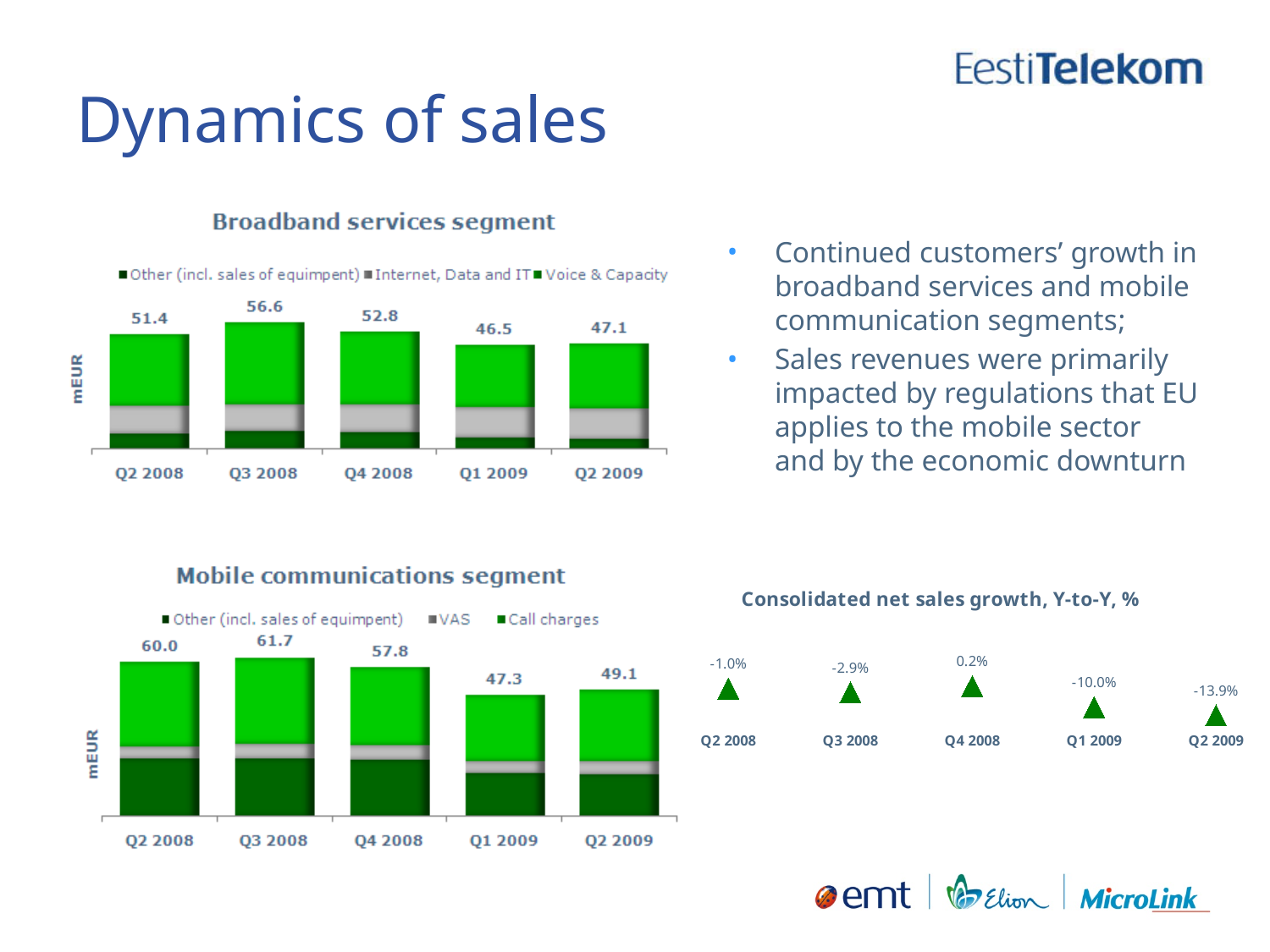
In the Broadband services segment chart, what is the total value for Q3 2008? 56.6 In the Mobile communications segment chart, what is the difference between the Q2 2008 total and the Q2 2009 total? 10.9 In the Consolidated net sales growth, Y-to-Y, % chart, which quarter has the highest value? Q4 2008 What kind of chart is the Mobile communications segment chart? Stacked bar chart In the Broadband services segment chart, how many series does the legend list? 3 In the Mobile communications segment chart, what is the total value for Q2 2009? 49.1 In the Mobile communications segment chart, which is larger, the total for Q2 2008 or the total for Q2 2009? Q2 2008 In the Consolidated net sales growth, Y-to-Y, % chart, how many quarters are shown? 5 In the Consolidated net sales growth, Y-to-Y, % chart, what is the value for Q1 2009? -10.0% In the Mobile communications segment chart, which quarter has the highest total? Q3 2008 In the Broadband services segment chart, which quarter has the lowest total? Q1 2009 In the Broadband services segment chart, what is the difference between the Q3 2008 total and the Q1 2009 total? 10.1